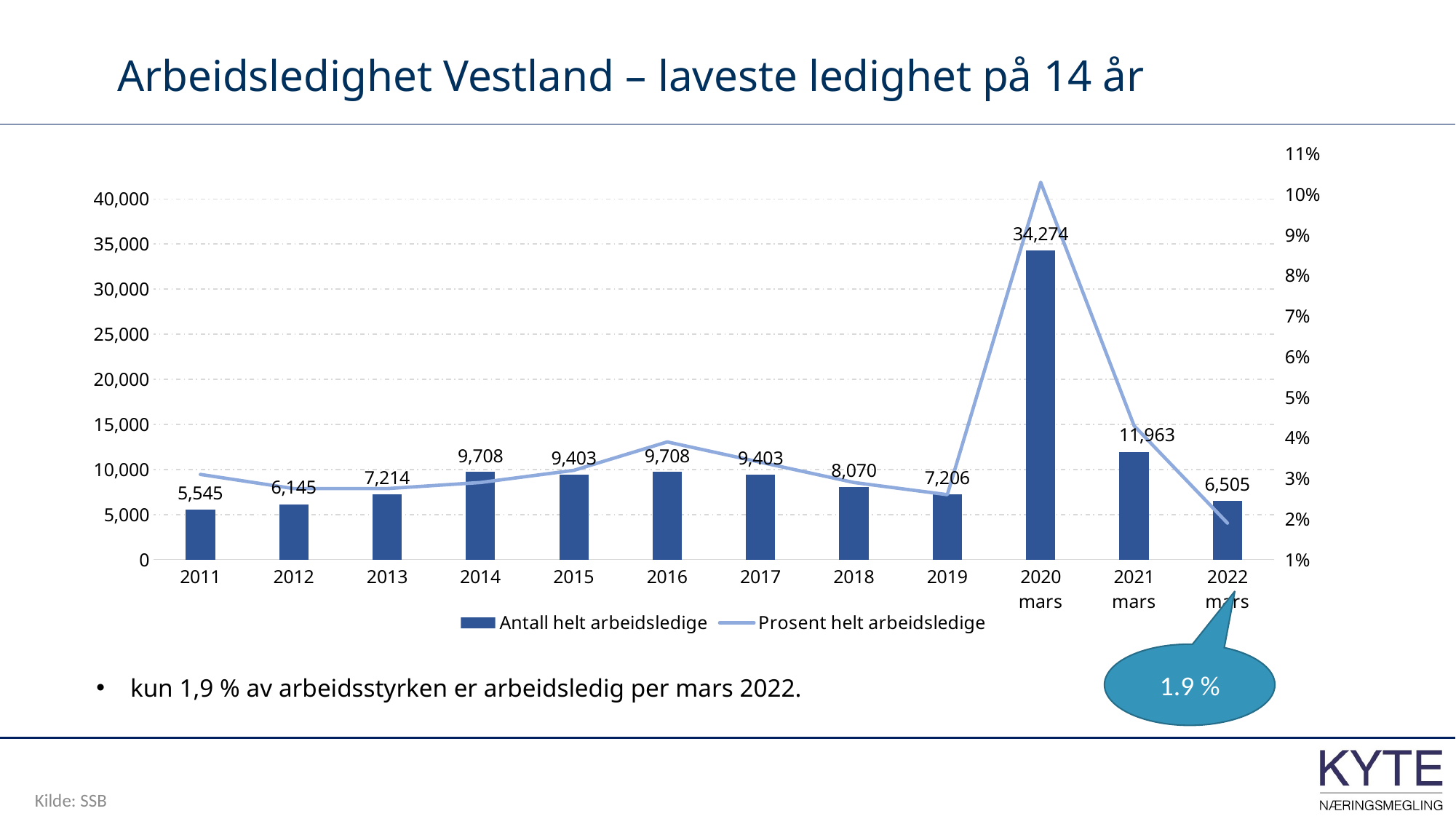
How many categories are shown on the x axis? 12 Which category has the lowest value for Antall helt arbeidsledige? 2011 What is the value of Antall helt arbeidsledige for 2011? 5,545 What is the value of Antall helt arbeidsledige for 2018? 8,070 What is the value of Antall helt arbeidsledige for 2020 mars? 34,274 Is the value of Prosent helt arbeidsledige for 2020 mars greater or less than 9%? greater Do the values of Antall helt arbeidsledige rise or fall from 2020 mars to 2022 mars? fall Which has the larger value for Antall helt arbeidsledige, 2018 or 2019? 2018 Which category has the highest value for Antall helt arbeidsledige? 2020 mars What kind of chart is shown on the slide? Combined bar and line chart What is the difference in Antall helt arbeidsledige between 2021 mars and 2022 mars? 5,458 How many series does the legend list? 2